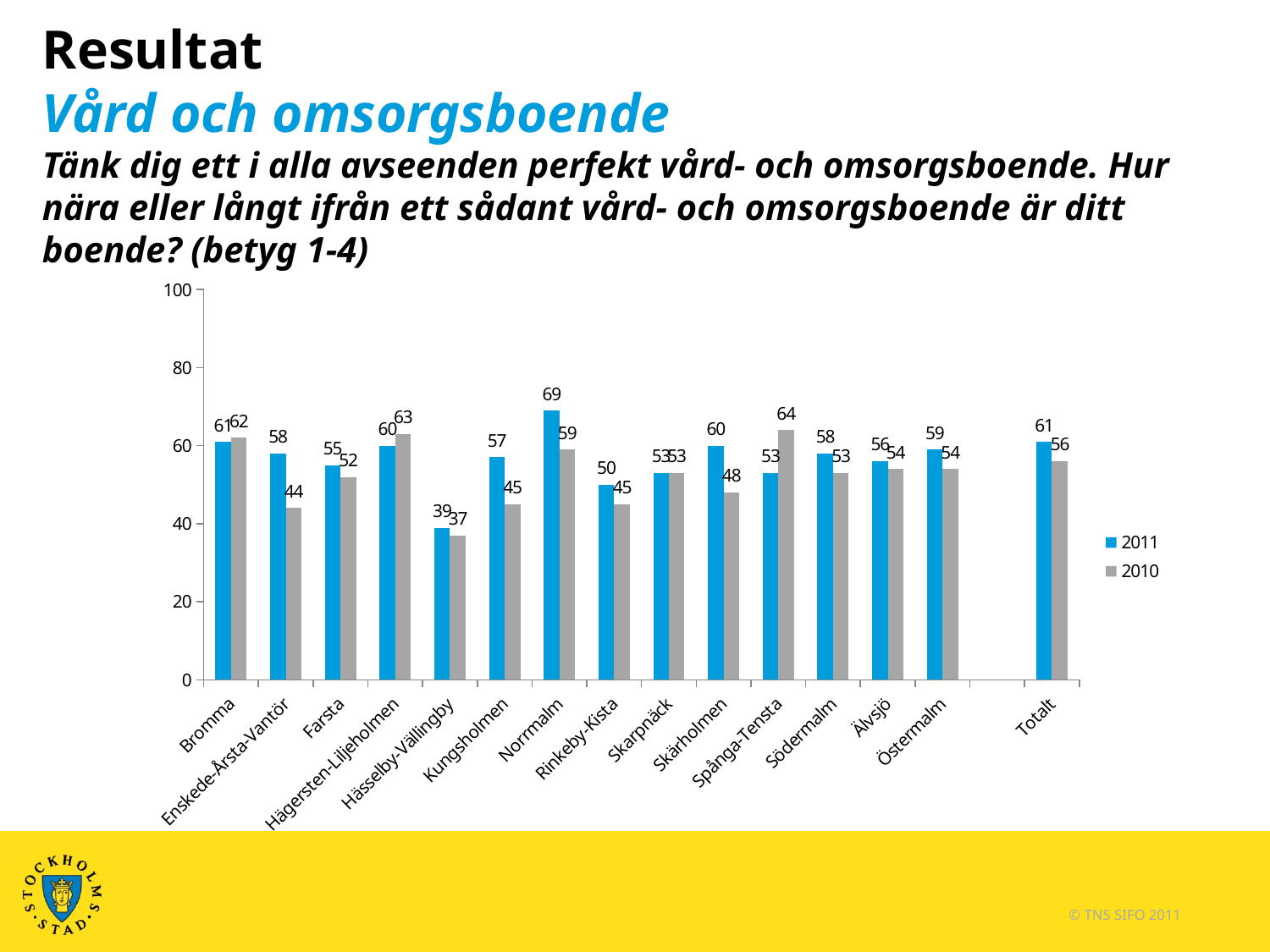
What kind of chart is shown on the slide? bar chart How many categories are shown on the x axis? 15 Which is larger for Spånga-Tensta, the 2011 value or the 2010 value? 2010 What is the 2011 value for Totalt? 61 Which colour represents the 2010 series in the legend? grey What is the 2010 value for Enskede-Årsta-Vantör? 44 Is the 2011 value for Hässelby-Vällingby greater or less than 40? less Which category has the lowest 2010 value? Hässelby-Vällingby How many series does the legend list? 2 Which category has the highest 2011 value? Norrmalm What is the difference between the 2011 and 2010 values for Kungsholmen? 12 What is the 2011 value for Norrmalm? 69